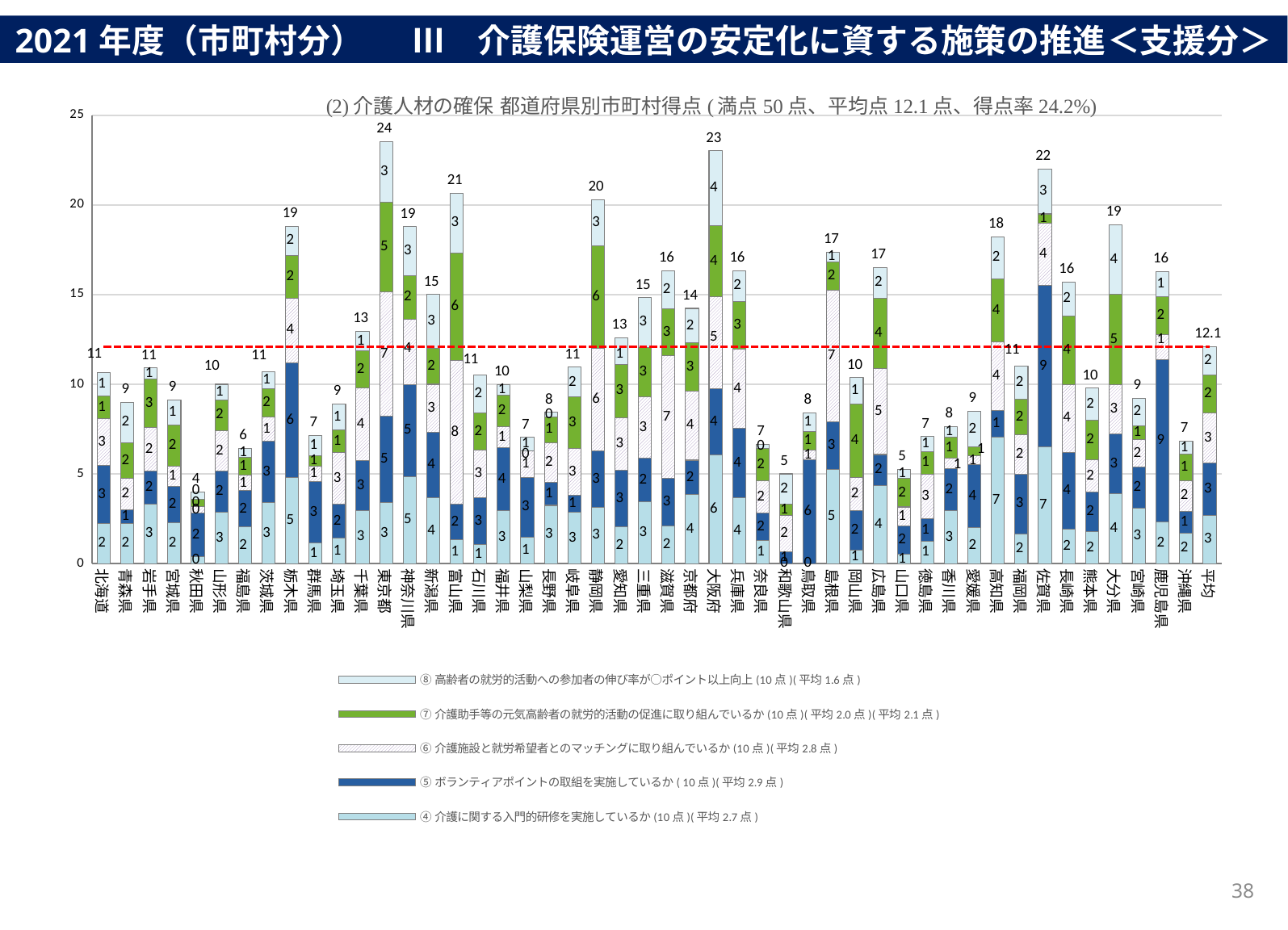
What is the difference between the total scores of 佐賀県 and 秋田県? 18 What is the total score shown for 鹿児島県? 16 Which has a higher total score, 栃木県 or 静岡県? 静岡県 Which prefecture has the highest total score? 東京都 How many series does the legend list? 5 What is the value shown for 平均 (the average bar)? 12.1 What value does the red dashed horizontal line mark? 12.1 Which prefecture has the lowest total score? 秋田県 What is the total score shown for 東京都? 24 Is the total score for 和歌山県 greater or less than 10? less What is the difference between the total scores of 東京都 and 大阪府? 1 What kind of chart is shown on the slide? Stacked bar chart